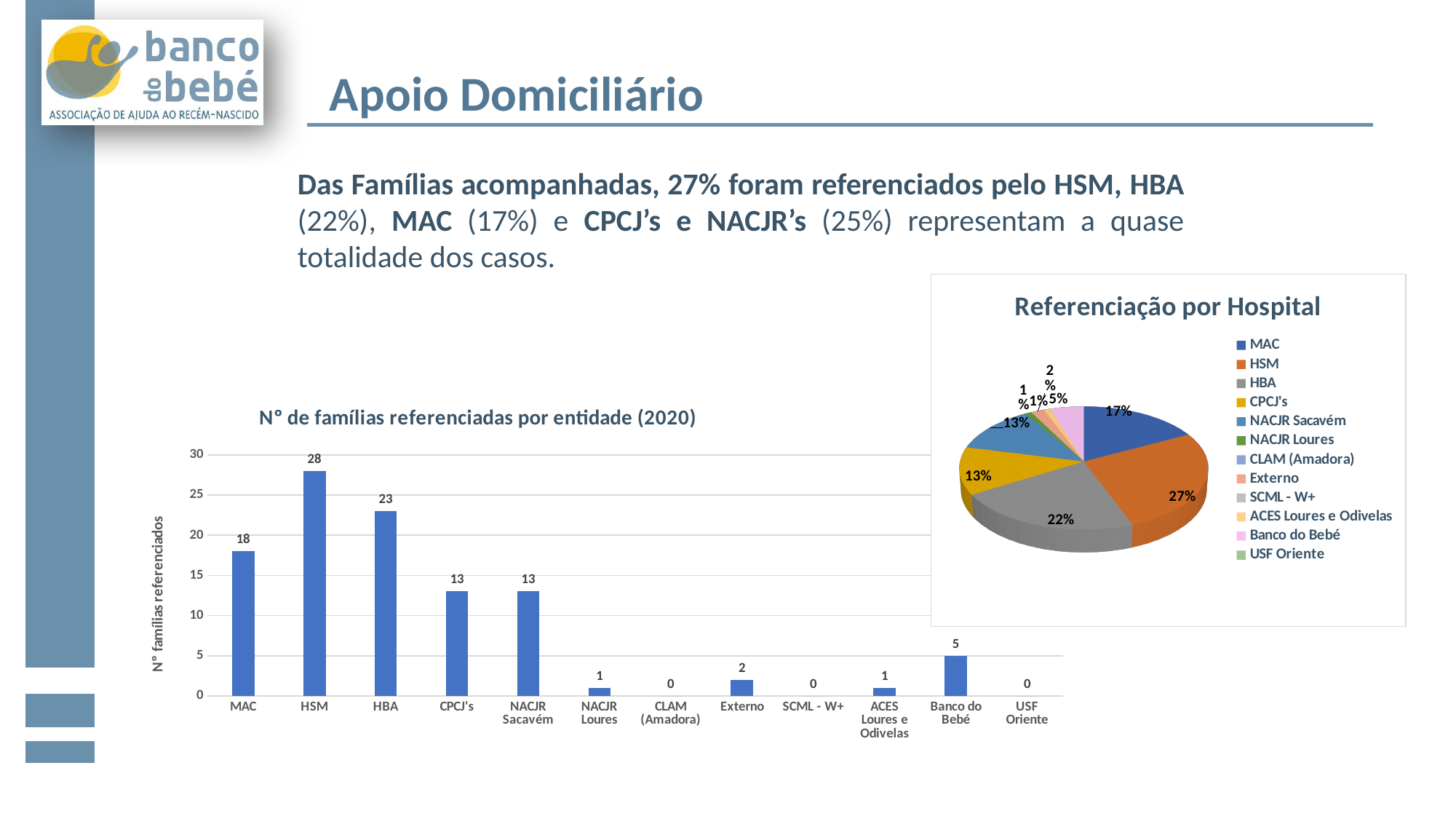
In the pie chart 'Referenciação por Hospital', which hospital has the largest slice? HSM What type of chart is 'Nº de famílias referenciadas por entidade (2020)'? Bar chart In the bar chart 'Nº de famílias referenciadas por entidade (2020)', what is the difference between the values for HSM and HBA? 5 In the bar chart 'Nº de famílias referenciadas por entidade (2020)', what is the value for Banco do Bebé? 5 How many entries does the legend of the pie chart 'Referenciação por Hospital' list? 12 In the bar chart 'Nº de famílias referenciadas por entidade (2020)', which entity has the highest number of referenced families? HSM In the bar chart 'Nº de famílias referenciadas por entidade (2020)', which is larger, the value for MAC or the value for HBA? HBA In the bar chart 'Nº de famílias referenciadas por entidade (2020)', how many families were referenced by HSM? 28 In the bar chart 'Nº de famílias referenciadas por entidade (2020)', how many entities are shown on the x axis? 12 In the pie chart 'Referenciação por Hospital', what share does HBA have? 22% In the pie chart 'Referenciação por Hospital', what share does HSM have? 27% In the bar chart 'Nº de famílias referenciadas por entidade (2020)', how many entities have a value of 0? 3